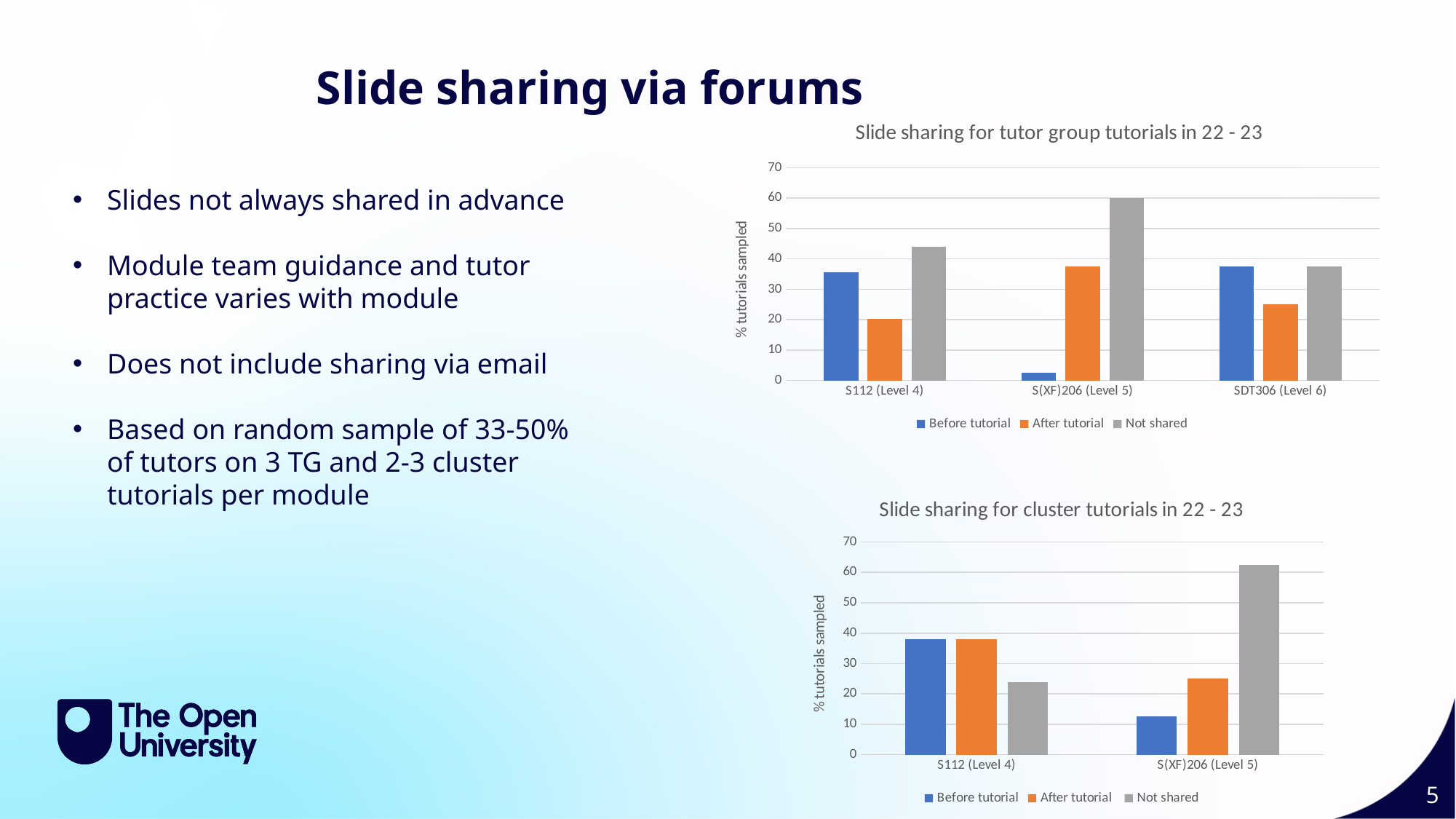
In the "Slide sharing for tutor group tutorials in 22 - 23" chart, which module has the lowest "Before tutorial" bar? S(XF)206 (Level 5) In the "Slide sharing for cluster tutorials in 22 - 23" chart, which is larger for S(XF)206 (Level 5): "Before tutorial" or "After tutorial"? After tutorial In the "Slide sharing for cluster tutorials in 22 - 23" chart, which is larger for S112 (Level 4): "Before tutorial" or "Not shared"? Before tutorial In the "Slide sharing for tutor group tutorials in 22 - 23" chart, is the "Before tutorial" value for S(XF)206 (Level 5) greater or less than 10? less What type of chart is "Slide sharing for tutor group tutorials in 22 - 23"? bar chart In the "Slide sharing for cluster tutorials in 22 - 23" chart, is the "Not shared" value for S(XF)206 (Level 5) greater or less than 60? greater What is the y-axis label on the "Slide sharing for cluster tutorials in 22 - 23" chart? % tutorials sampled In the "Slide sharing for tutor group tutorials in 22 - 23" chart, which module has the highest "Not shared" bar? S(XF)206 (Level 5) How many module categories are shown on the x axis of the "Slide sharing for cluster tutorials in 22 - 23" chart? 2 How many series does the legend list in the "Slide sharing for cluster tutorials in 22 - 23" chart? 3 How many module categories are shown on the x axis of the "Slide sharing for tutor group tutorials in 22 - 23" chart? 3 In the "Slide sharing for tutor group tutorials in 22 - 23" chart, is the "Not shared" value for S(XF)206 (Level 5) greater or less than 50? greater